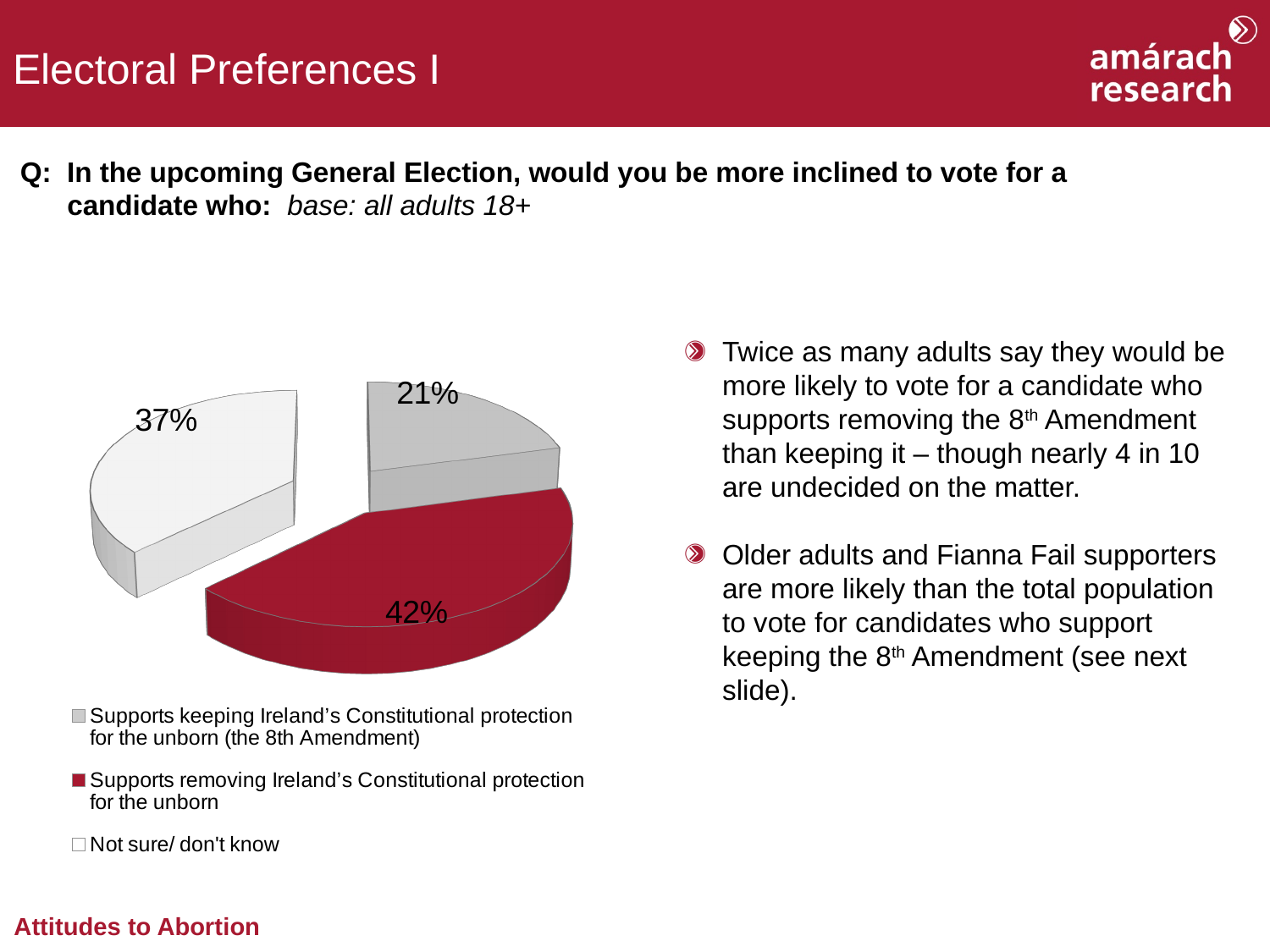
Which response has the largest share of the pie? Supports removing Ireland's Constitutional protection for the unborn What percentage of adults would be more inclined to vote for a candidate who supports removing Ireland's Constitutional protection for the unborn? 42% What colour is the slice representing 'Supports removing Ireland's Constitutional protection for the unborn'? Red How many entries does the legend list? 3 What is the difference in percentage points between those supporting removing the 8th Amendment and those supporting keeping it? 21 What percentage of adults would be more inclined to vote for a candidate who supports keeping the 8th Amendment? 21% Which is larger: the share for 'Not sure/ don't know' or the share for supporting removal of the Constitutional protection? Supports removing Ireland's Constitutional protection for the unborn Which response has the smallest share of the pie? Supports keeping Ireland's Constitutional protection for the unborn (the 8th Amendment) How many slices does the pie chart have? 3 What type of chart is shown on the slide? Pie chart What percentage of adults answered 'Not sure/ don't know'? 37% What is the difference in percentage points between 'Not sure/ don't know' and 'Supports keeping' the 8th Amendment? 16